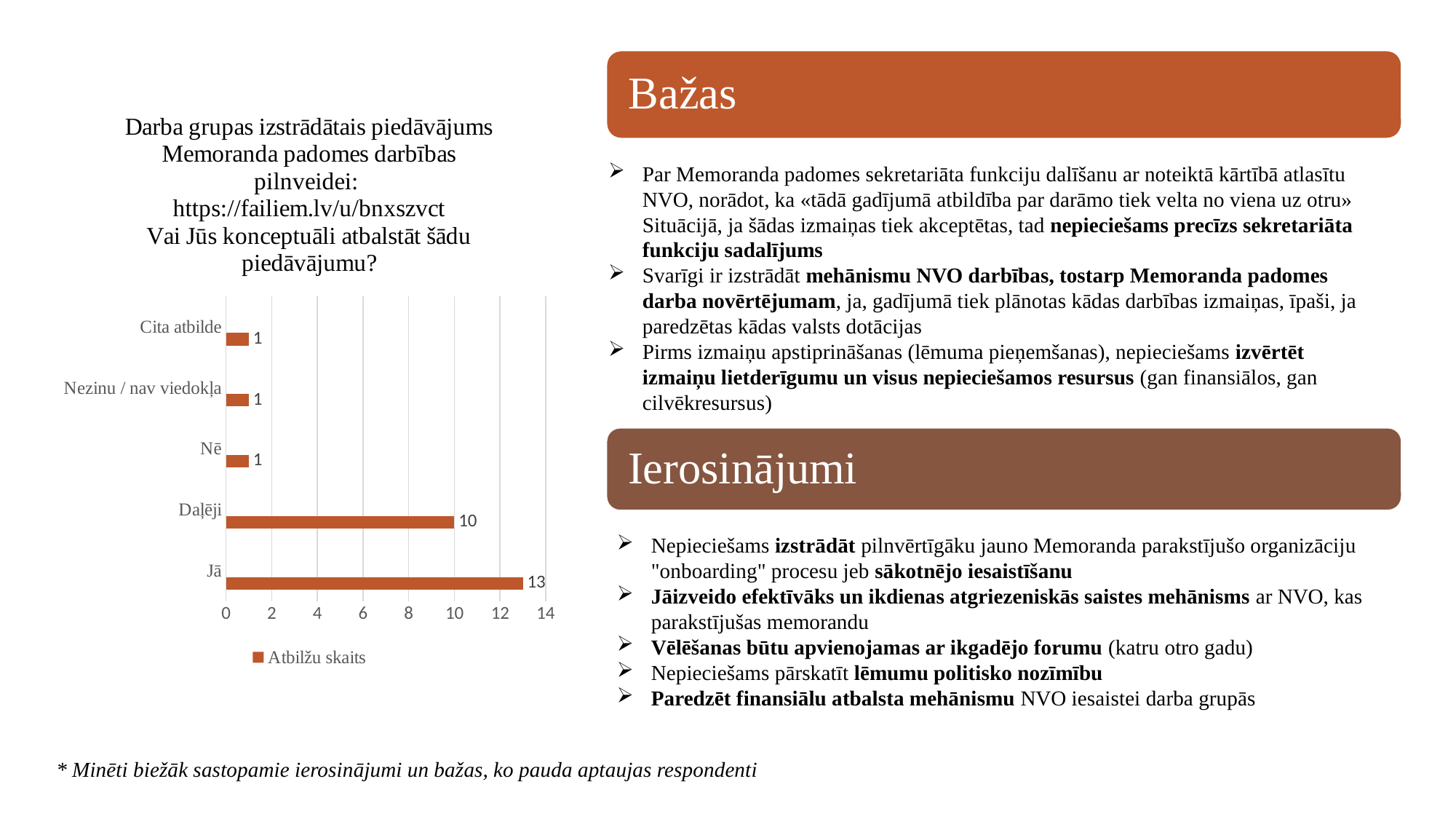
How many series does the legend list? 1 What is the value for "Nē"? 1 What is the value for "Cita atbilde"? 1 Which category has the highest value? Jā What is the difference between the values for "Jā" and "Daļēji"? 3 What kind of chart is shown on the slide? bar chart How many categories are shown in the chart? 5 What is the value for "Daļēji"? 10 What is the name of the series shown in the legend? Atbilžu skaits Is the value for "Jā" greater or less than 12? greater Which is larger, the value for "Daļēji" or the value for "Nezinu / nav viedokļa"? Daļēji What is the value for "Jā"? 13